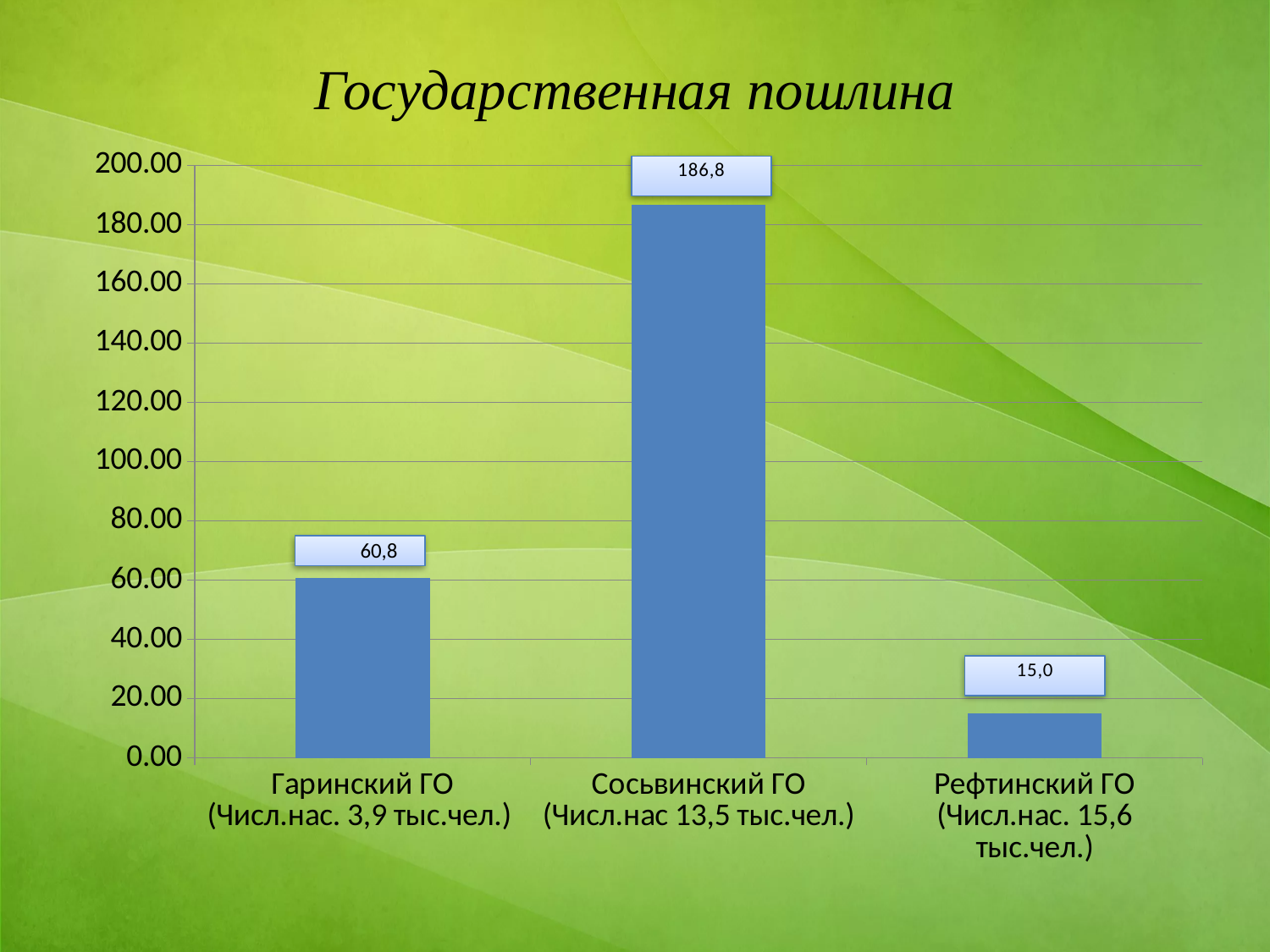
What is the difference between the values for Гаринский ГО and Рефтинский ГО? 45,8 What kind of chart is shown on the slide? bar chart Which category has the highest value? Сосьвинский ГО What is the title of the chart? Государственная пошлина Which category has the lowest value? Рефтинский ГО How many categories are shown on the chart? 3 Which is larger, the value for Гаринский ГО or the value for Рефтинский ГО? Гаринский ГО What is the value for Сосьвинский ГО? 186,8 What is the value for Гаринский ГО? 60,8 What is the difference between the values for Сосьвинский ГО and Гаринский ГО? 126,0 Is the value for Сосьвинский ГО greater or less than 180? greater What is the value for Рефтинский ГО? 15,0